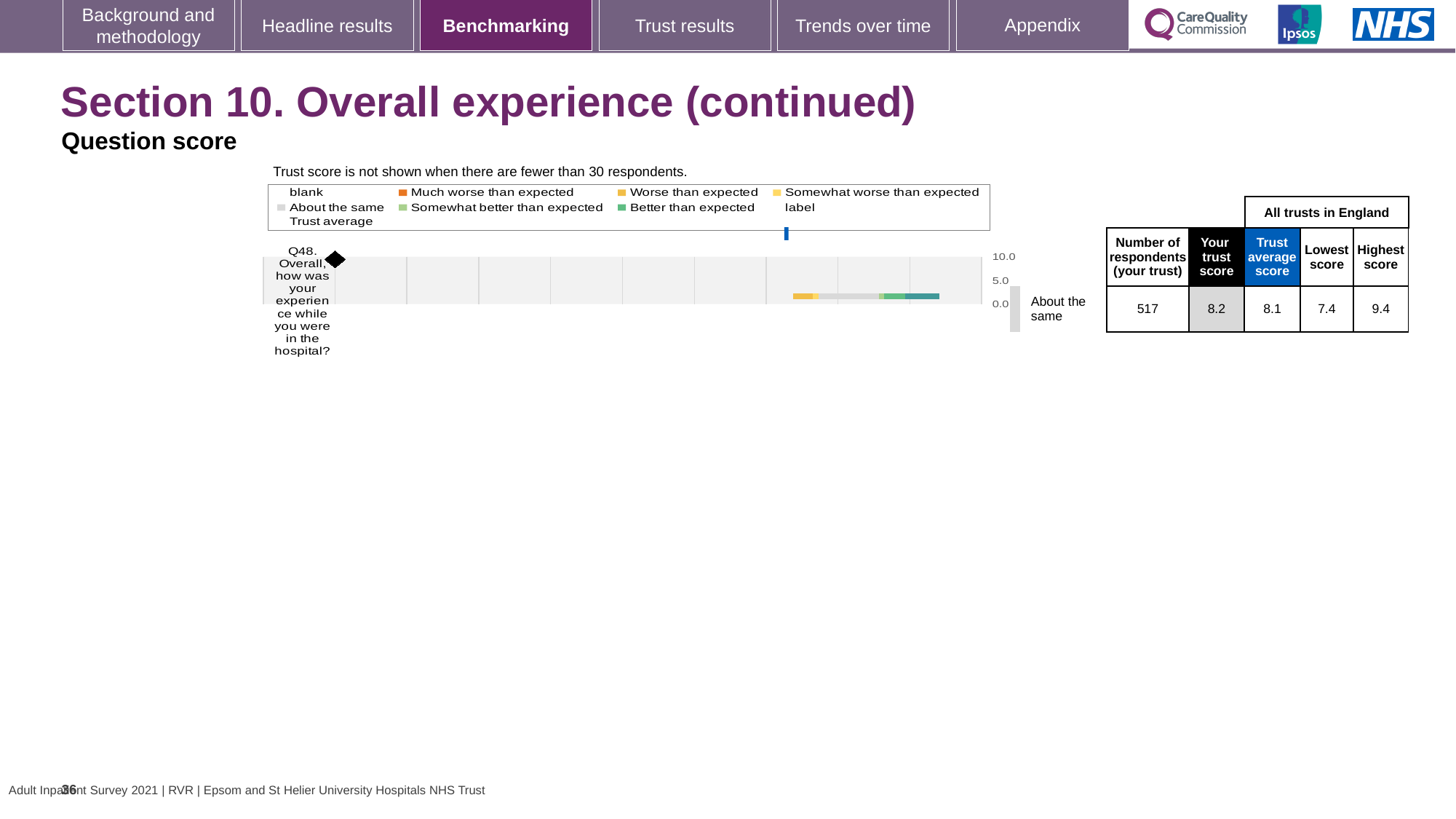
According to the table, what is the highest score for Q48 among all trusts in England? 9.4 According to the table, what is the trust average score for Q48 across all trusts in England? 8.1 Which question is plotted in the benchmarking chart? Q48. Overall, how was your experience while you were in the hospital? According to the table, what is the lowest score for Q48 among all trusts in England? 7.4 How many questions are plotted in the benchmarking chart? 1 What is the highest value shown on the chart's axis? 10.0 What kind of chart is used to show the Q48 benchmarking result? bar chart What benchmark category is shown next to the Q48 bar? About the same According to the table, what is the trust's score for Q48? 8.2 How many respondents from the trust answered Q48? 517 What is the difference between the highest score and the lowest score for Q48 among all trusts in England? 2.0 Which is larger for Q48: the trust's score or the trust average score? the trust's score